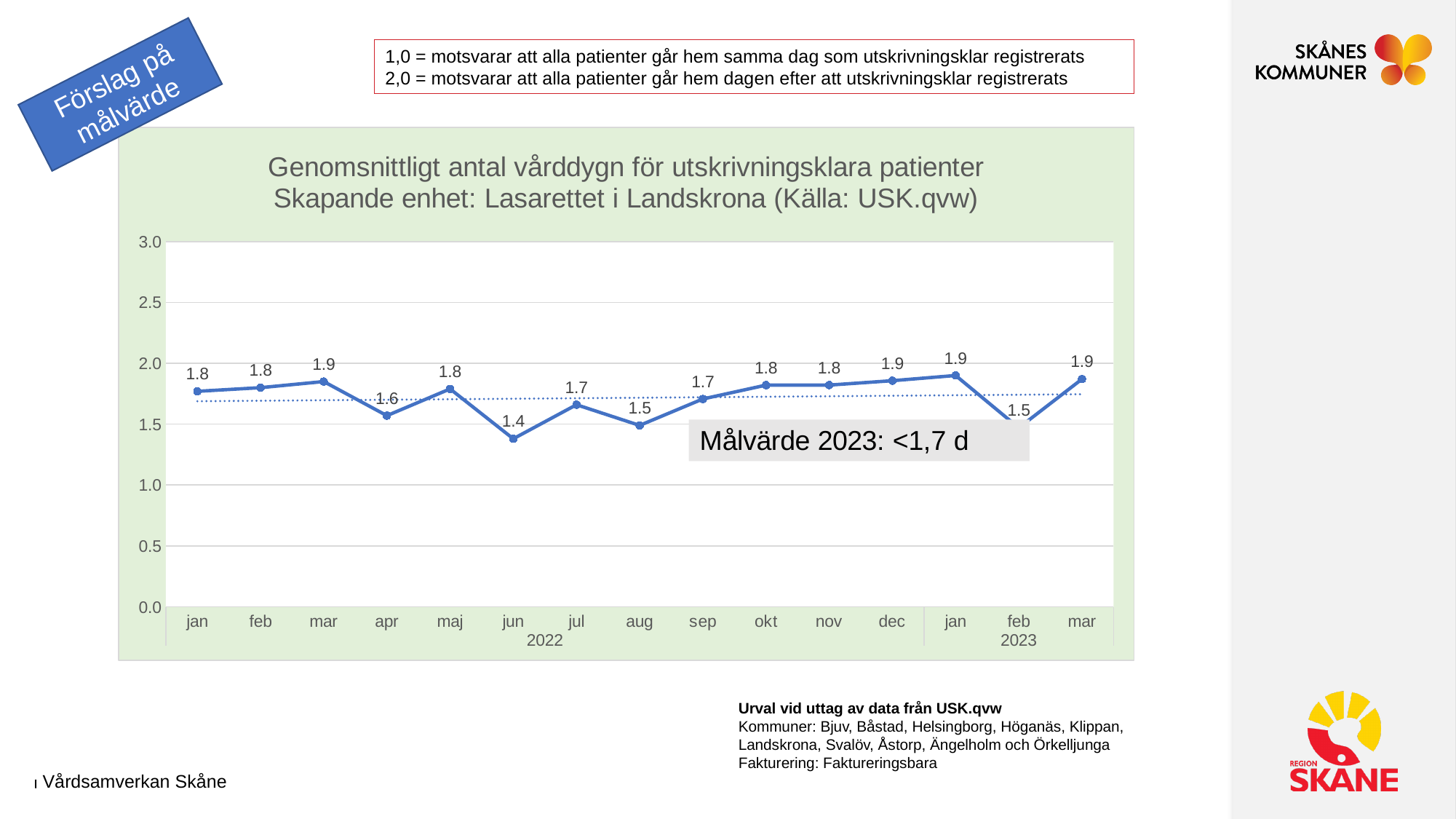
What is the difference between the values for jan 2023 and feb 2023? 0.4 What type of chart is shown on the slide? line chart Does the value rise or fall from jan 2023 to feb 2023? fall What is the value for apr 2022? 1.6 What is the value for feb 2023? 1.5 How many monthly data points are plotted on the chart? 15 What is the value for mar 2023? 1.9 Is the value for mar 2023 greater or less than 2.0? less Which is larger, the value for apr 2022 or the value for maj 2022? maj 2022 What is the value for jun 2022? 1.4 What target value (Målvärde) for 2023 is shown on the chart? <1,7 d Which month has the lowest value? jun 2022